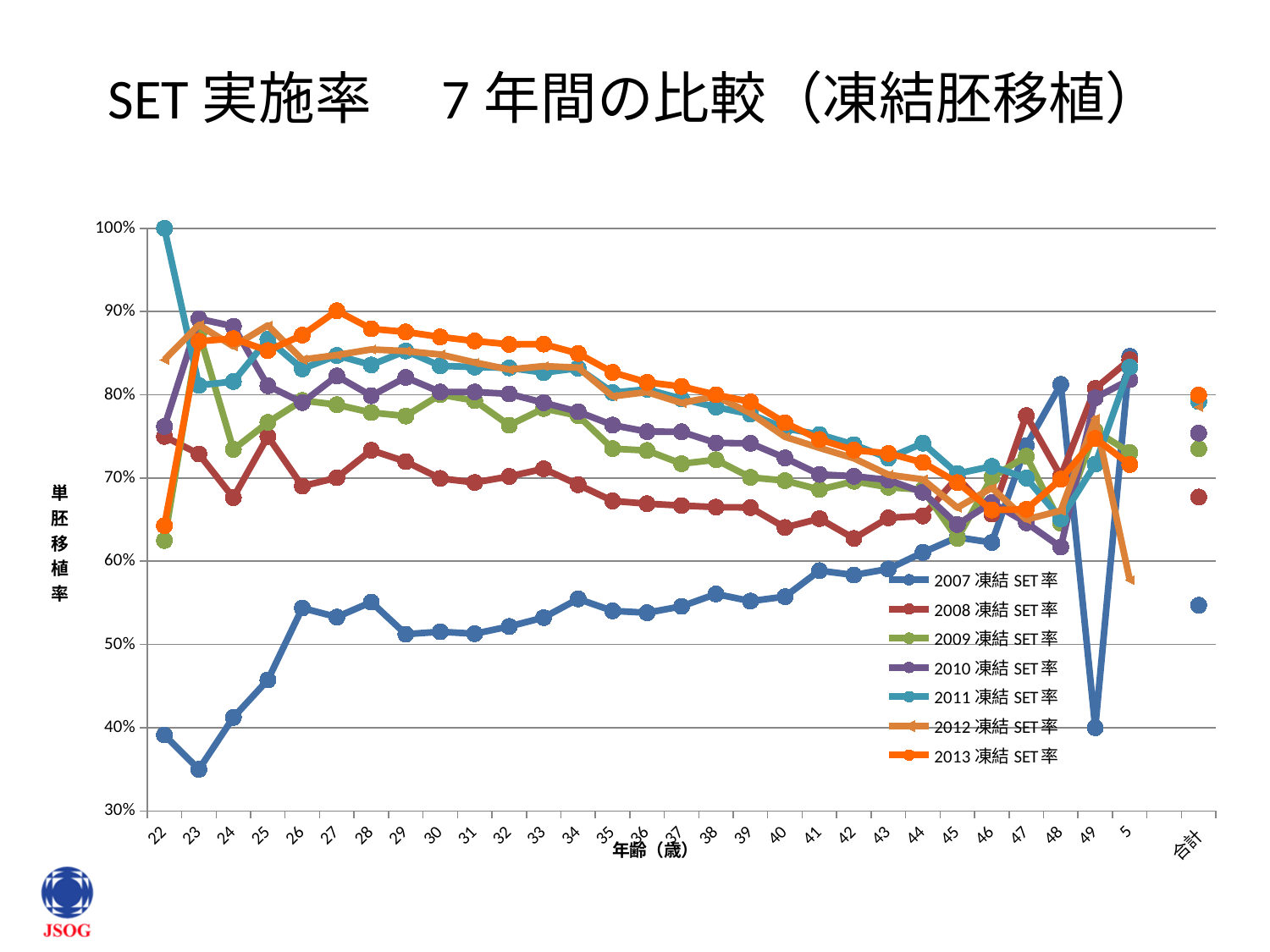
What is the value of the 2011 凍結 SET率 series at age 22? 100% What is the label on the x axis of the chart? 年齢（歳） What kind of chart is shown on the slide? line chart At which age does the 2007 凍結 SET率 series reach its lowest value? 23 Which series has the lowest value at age 30? 2007 凍結 SET率 Is the 合計 value of the 2007 凍結 SET率 series greater or less than 60%? less How many series does the legend list? 7 Which series has the highest value at age 22? 2011 凍結 SET率 What is the title of the chart? SET 実施率 7 年間の比較（凍結胚移植） Is the value of the 2007 凍結 SET率 series at age 23 greater or less than 40%? less At age 35, which is larger: the 2013 凍結 SET率 value or the 2007 凍結 SET率 value? 2013 凍結 SET率 Is the value of the 2013 凍結 SET率 series at age 27 greater or less than 80%? greater